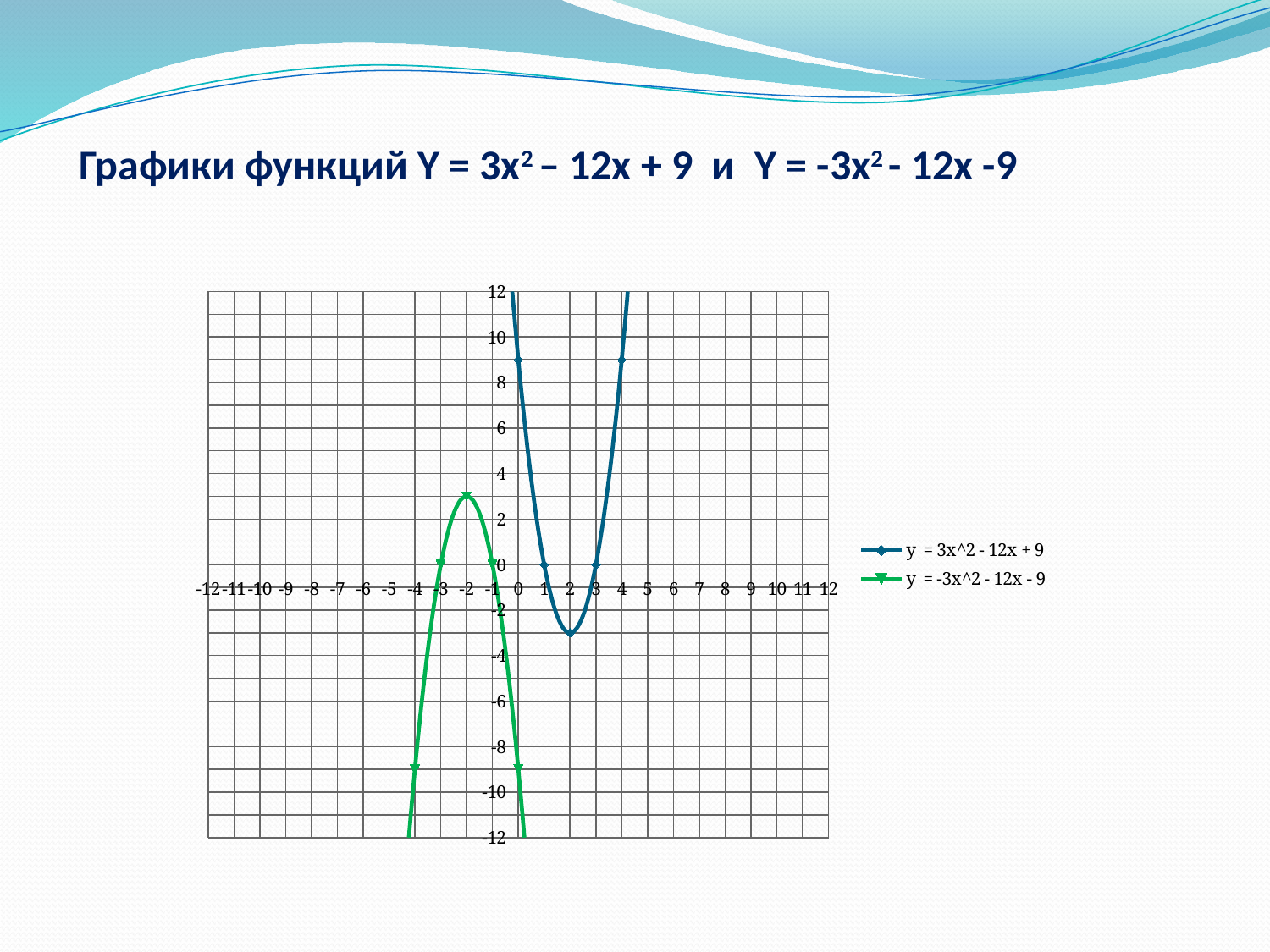
Is the value of the series y = 3x^2 - 12x + 9 at x = 2 greater or less than 0? less At x = 0, which series has the higher value, y = 3x^2 - 12x + 9 or y = -3x^2 - 12x - 9? y = 3x^2 - 12x + 9 What is the value of the series y = 3x^2 - 12x + 9 at x = 3? 0 What is the value of the series y = -3x^2 - 12x - 9 at x = -1? 0 Does the series y = 3x^2 - 12x + 9 rise or fall as x goes from 2 to 4? rise What is the value of the series y = -3x^2 - 12x - 9 at x = -3? 0 What is the value of the series y = 3x^2 - 12x + 9 at x = 1? 0 How many series does the legend list? 2 Is the value of the series y = -3x^2 - 12x - 9 at x = 0 greater or less than -8? less What are the two series names shown in the legend? y = 3x^2 - 12x + 9 and y = -3x^2 - 12x - 9 Is the value of the series y = 3x^2 - 12x + 9 at x = 0 greater or less than 8? greater What kind of chart is shown on the slide? line chart